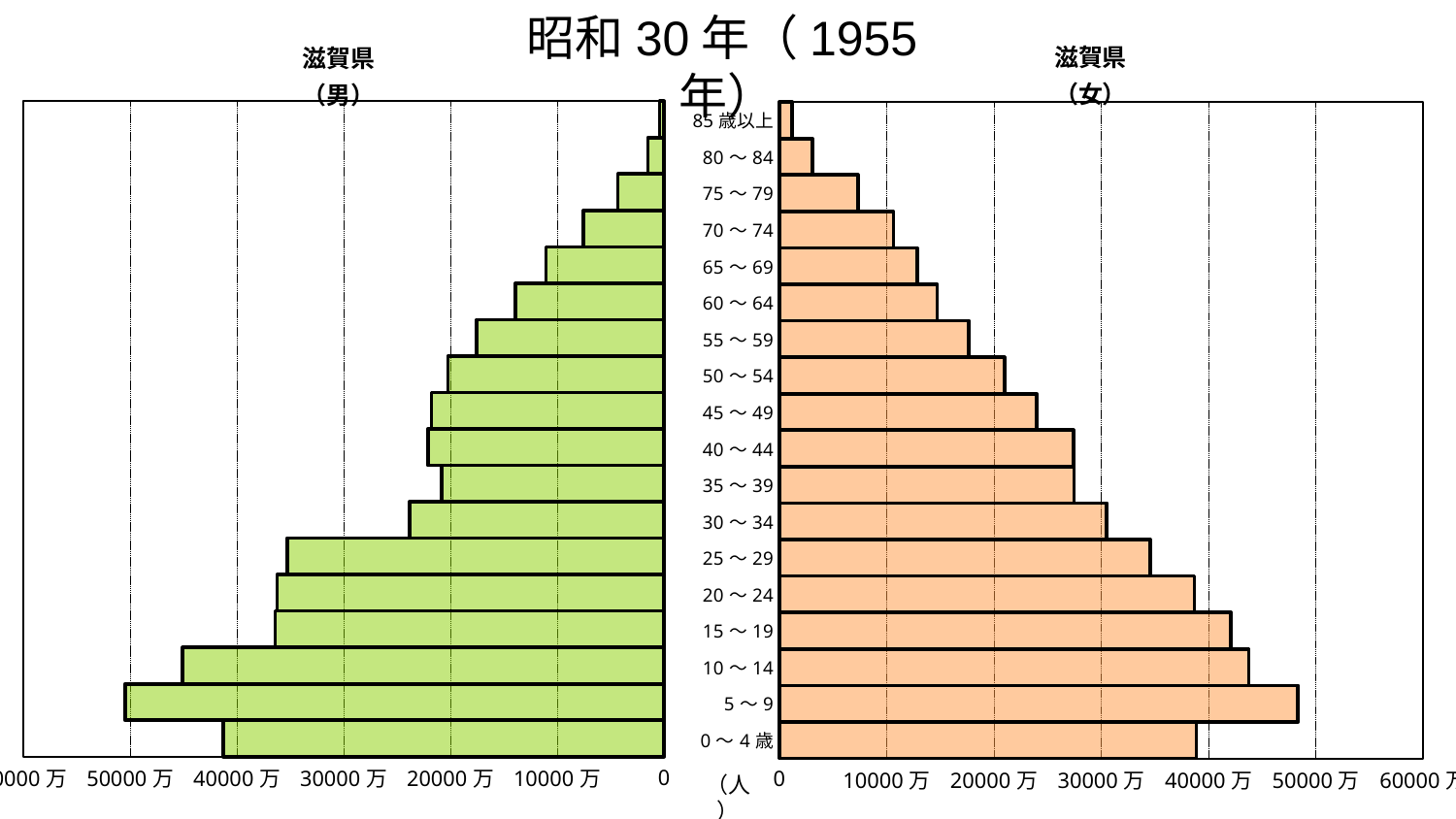
In the 滋賀県（女） chart, is the value for 5～9 greater or less than 50000万? less In the 滋賀県（男） chart, is the value for 70～74 greater or less than 10000万? less What kind of chart is shown on the slide? Bar chart (population pyramid) In the 滋賀県（男） chart, which is larger: 10～14 or 15～19? 10～14 What is the title shown at the top of the slide? 昭和30年（1955年） In the 滋賀県（女） chart, do the bars generally get longer or shorter as age increases from 5～9 to 85歳以上? shorter In the 滋賀県（女） chart, is the value for 55～59 greater or less than 20000万? less How many age categories are shown on the slide? 18 In the 滋賀県（女） chart, which age group has the shortest bar? 85歳以上 Which is larger: the 30～34 value in the 滋賀県（男） chart or the 30～34 value in the 滋賀県（女） chart? 滋賀県（女） In the 滋賀県（男） chart, which age group has the longest bar? 5～9